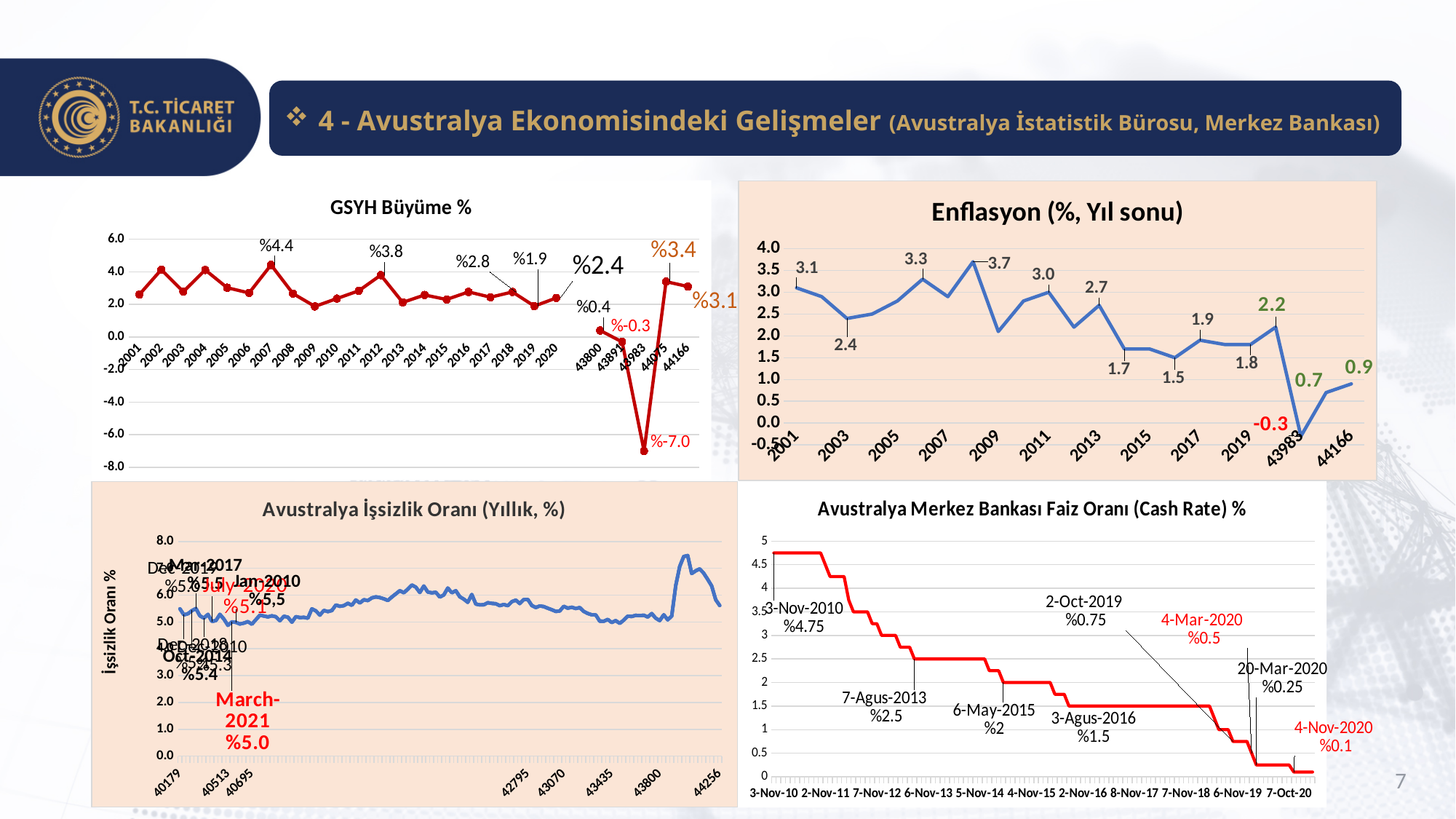
In the 'GSYH Büyüme %' chart, what is the value labelled for 2012? %3.8 In the 'Enflasyon (%, Yıl sonu)' chart, what is the difference between the 2001 value and the 2011 value? 0.1 In the 'Enflasyon (%, Yıl sonu)' chart, which year has the highest value? 2008 In the 'GSYH Büyüme %' chart, what is the value labelled for 2007? %4.4 In the 'Avustralya İşsizlik Oranı (Yıllık, %)' chart, what value is annotated for March-2021? %5.0 In the 'GSYH Büyüme %' chart, which point has the lowest value? 43983 In the 'Avustralya Merkez Bankası Faiz Oranı (Cash Rate) %' chart, what rate is annotated for 4-Nov-2020? %0.1 In the 'Enflasyon (%, Yıl sonu)' chart, what is the value for 43983? -0.3 In the 'GSYH Büyüme %' chart, what is the value labelled for 43983? %-7.0 In the 'Avustralya Merkez Bankası Faiz Oranı (Cash Rate) %' chart, do the values rise or fall over time? fall In the 'Avustralya Merkez Bankası Faiz Oranı (Cash Rate) %' chart, what rate is annotated for 3-Nov-2010? %4.75